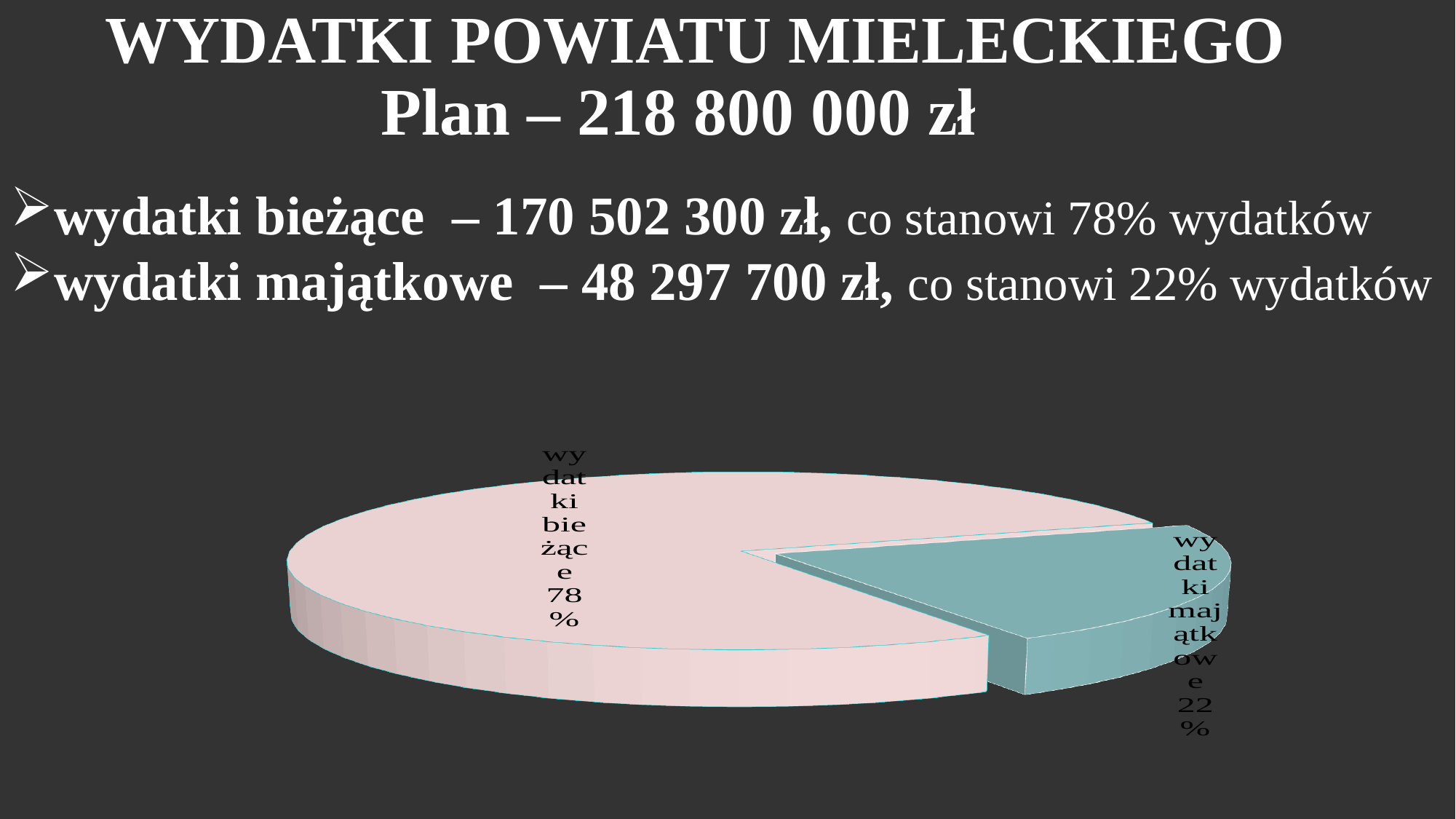
What colour is the 'wydatki bieżące' slice in the pie chart? light pink What colour is the 'wydatki majątkowe' slice in the pie chart? teal How many slices does the pie chart have? 2 By how many percentage points does the 'wydatki bieżące' share exceed the 'wydatki majątkowe' share? 56 What kind of chart is shown on the slide? pie chart What share of the pie does the 'wydatki majątkowe' slice represent? 22% Which slice of the pie chart is the largest? wydatki bieżące What share of the pie does the 'wydatki bieżące' slice represent? 78% Which is larger in the pie chart: 'wydatki bieżące' or 'wydatki majątkowe'? wydatki bieżące Which slice of the pie chart is the smallest? wydatki majątkowe Is the share of 'wydatki majątkowe' greater or less than 50%? less